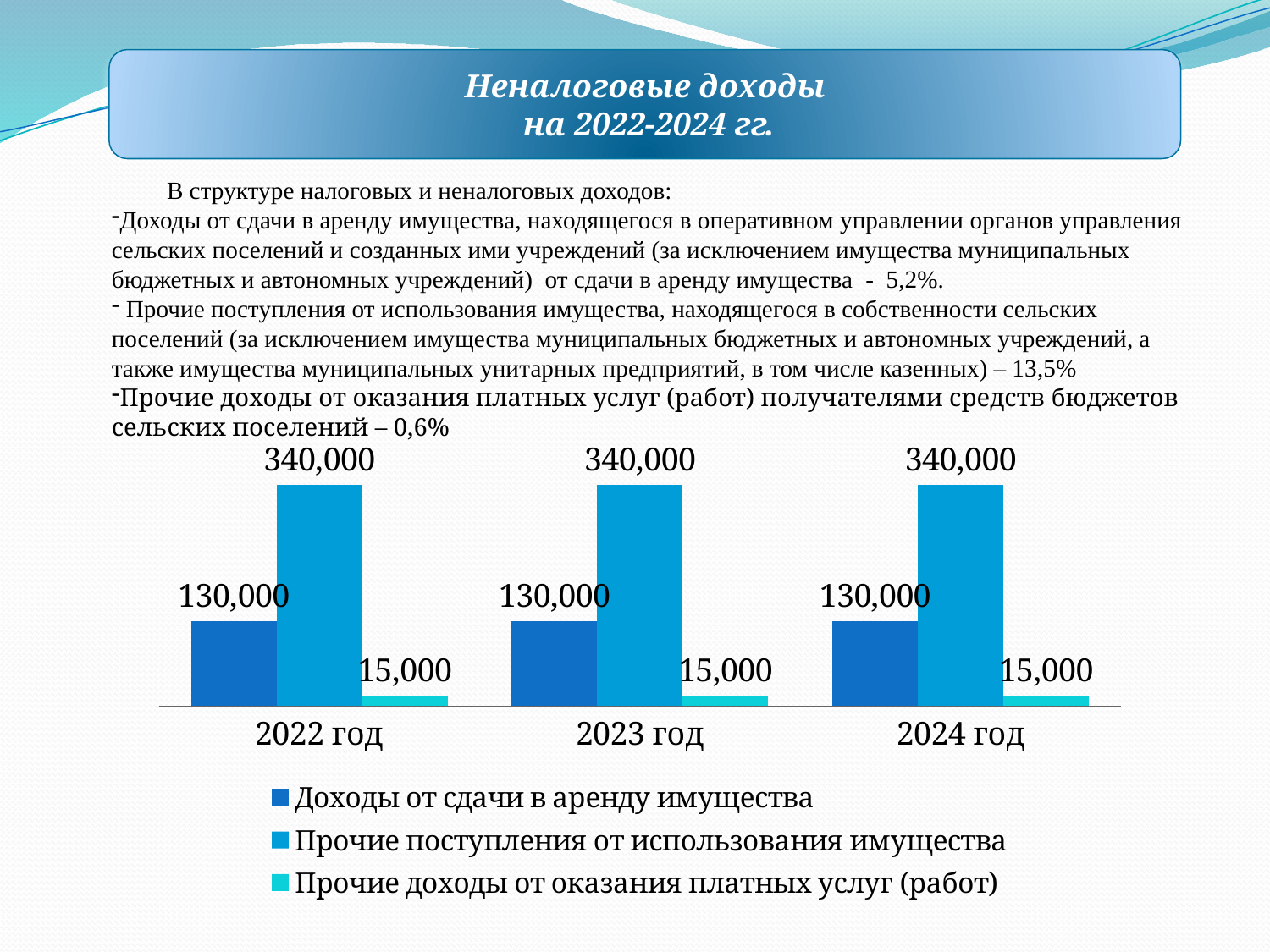
Does the value for Прочие поступления от использования имущества rise, fall or stay the same from 2022 год to 2024 год? stays the same Which is larger in 2022 год: Доходы от сдачи в аренду имущества or Прочие доходы от оказания платных услуг (работ)? Доходы от сдачи в аренду имущества Which series has the highest value in 2024 год? Прочие поступления от использования имущества Which series has the lowest value in 2022 год? Прочие доходы от оказания платных услуг (работ) What is the title of the slide containing the chart? Неналоговые доходы на 2022-2024 гг. What type of chart is shown on the slide? bar chart What is the difference between Прочие поступления от использования имущества and Доходы от сдачи в аренду имущества in 2023 год? 210,000 How many year categories are shown on the x axis? 3 What is the value for Доходы от сдачи в аренду имущества in 2022 год? 130,000 What is the value for Прочие доходы от оказания платных услуг (работ) in 2024 год? 15,000 What is the value for Прочие поступления от использования имущества in 2023 год? 340,000 How many series does the legend list? 3